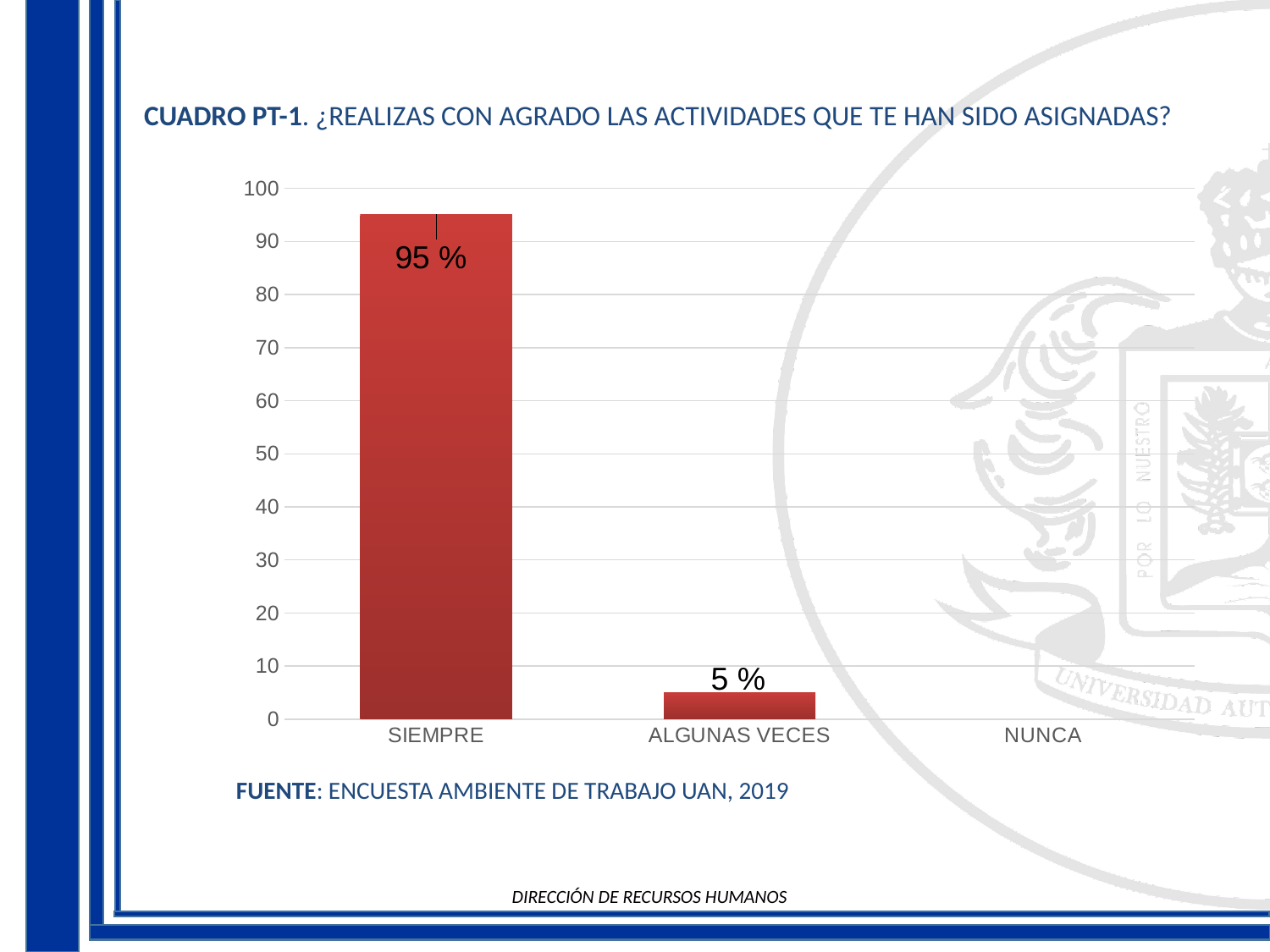
Is the value for SIEMPRE greater or less than 90? greater Which is larger, the value for SIEMPRE or the value for ALGUNAS VECES? SIEMPRE What is the value for SIEMPRE? 95 % Which category has the highest value? SIEMPRE How many categories are shown on the x axis? 3 What source is cited below the chart? ENCUESTA AMBIENTE DE TRABAJO UAN, 2019 Do the values rise or fall from SIEMPRE to ALGUNAS VECES? fall Is the value for ALGUNAS VECES greater or less than 10? less What kind of chart is shown on the slide? bar chart What is the highest value shown on the vertical axis? 100 What is the difference between the values for SIEMPRE and ALGUNAS VECES? 90 % What is the value for ALGUNAS VECES? 5 %